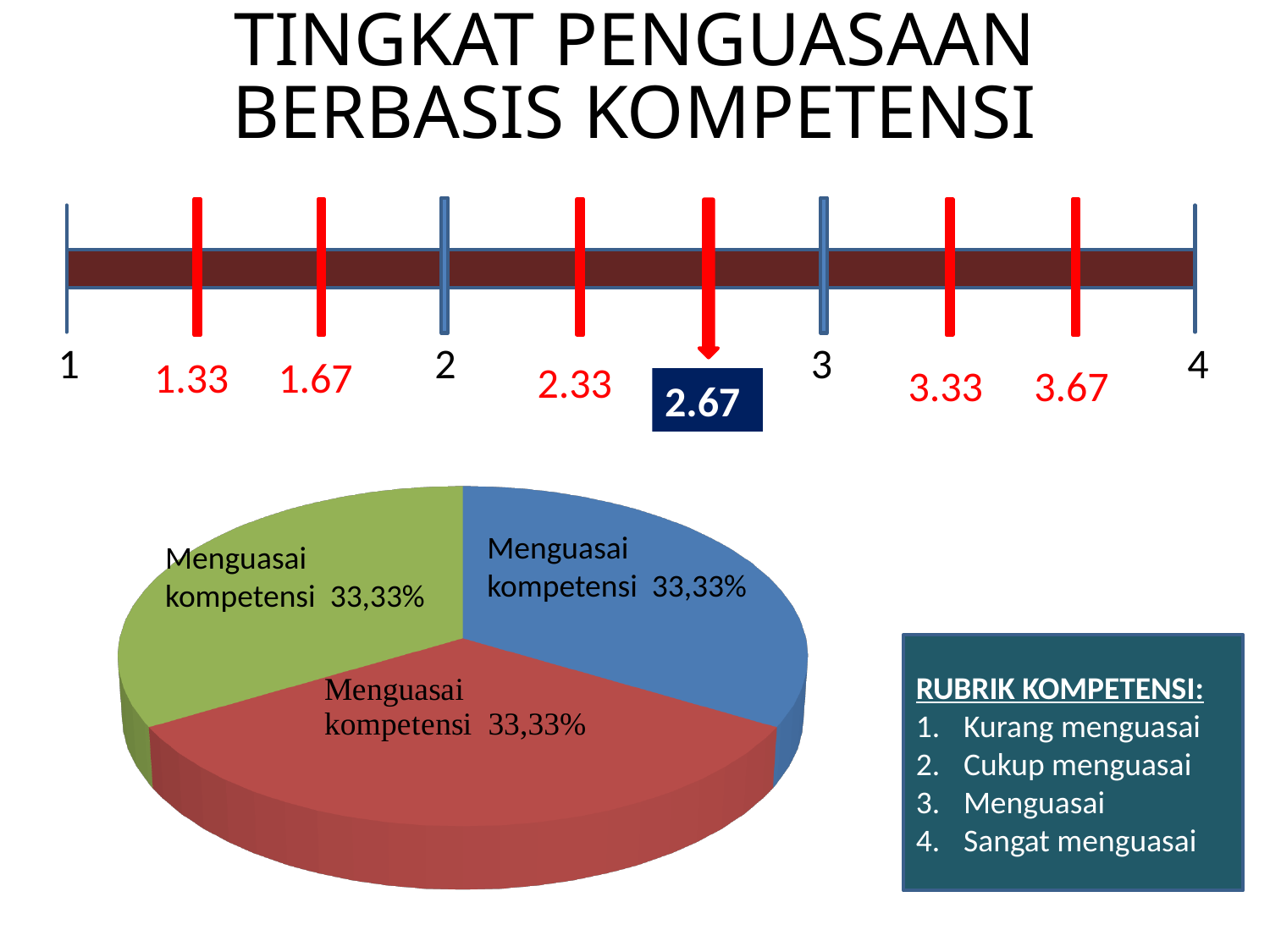
Are the three slices of the pie chart equal in size? Yes What kind of chart is shown on the slide? pie chart What is the total of the three slice percentages shown on the pie chart? 99,99% What are the three colours of the slices in the pie chart? blue, red and green What is the difference between the share of the blue slice and the share of the red slice? 0% What share of the pie does the green slice represent? 33,33% Is the share of the green slice greater or less than 50%? less How many slices does the pie chart have? 3 What share of the pie does the red slice represent? 33,33% What label text appears on each slice of the pie chart? Menguasai kompetensi What share of the pie does the blue slice represent? 33,33%